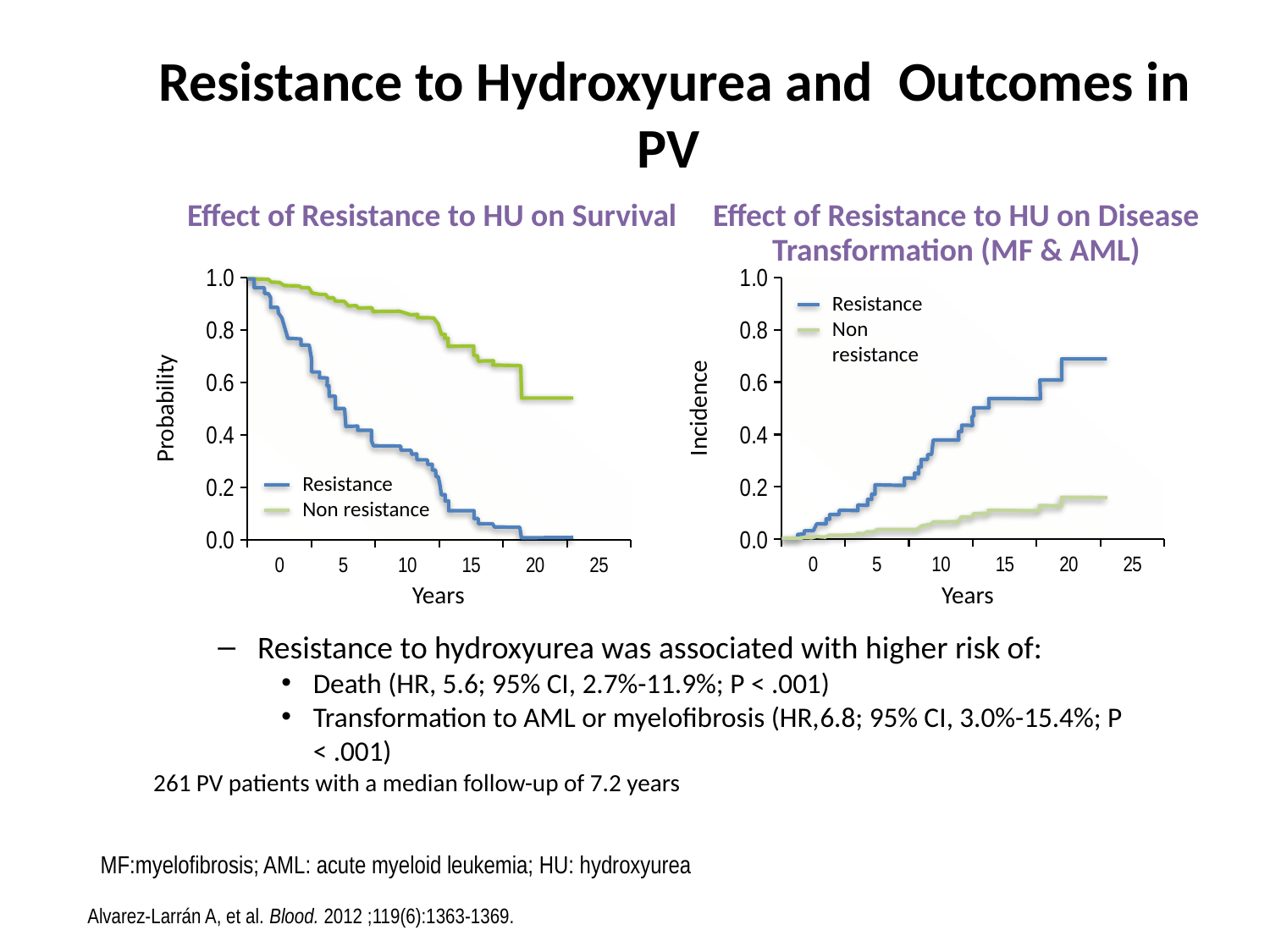
In the 'Effect of Resistance to HU on Survival' chart, does the Resistance curve rise or fall as years increase? fall In the 'Effect of Resistance to HU on Disease Transformation (MF & AML)' chart, does the Resistance curve rise or fall as years increase? rise In the 'Effect of Resistance to HU on Survival' chart, which series has the higher probability at 10 years, Resistance or Non resistance? Non resistance In the 'Effect of Resistance to HU on Disease Transformation (MF & AML)' chart, what is the label of the y axis? Incidence In the 'Effect of Resistance to HU on Survival' chart, is the Resistance probability at 15 years greater or less than 0.2? less In the 'Effect of Resistance to HU on Disease Transformation (MF & AML)' chart, which series has the higher incidence at 15 years, Resistance or Non resistance? Resistance What kind of chart is the 'Effect of Resistance to HU on Survival' chart? line chart In the 'Effect of Resistance to HU on Disease Transformation (MF & AML)' chart, is the Non resistance incidence at 20 years greater or less than 0.2? less In the 'Effect of Resistance to HU on Survival' chart, what is the label of the y axis? Probability How many series does the legend of the 'Effect of Resistance to HU on Survival' chart list? 2 In the 'Effect of Resistance to HU on Disease Transformation (MF & AML)' chart, is the Resistance incidence at 20 years greater or less than 0.6? greater